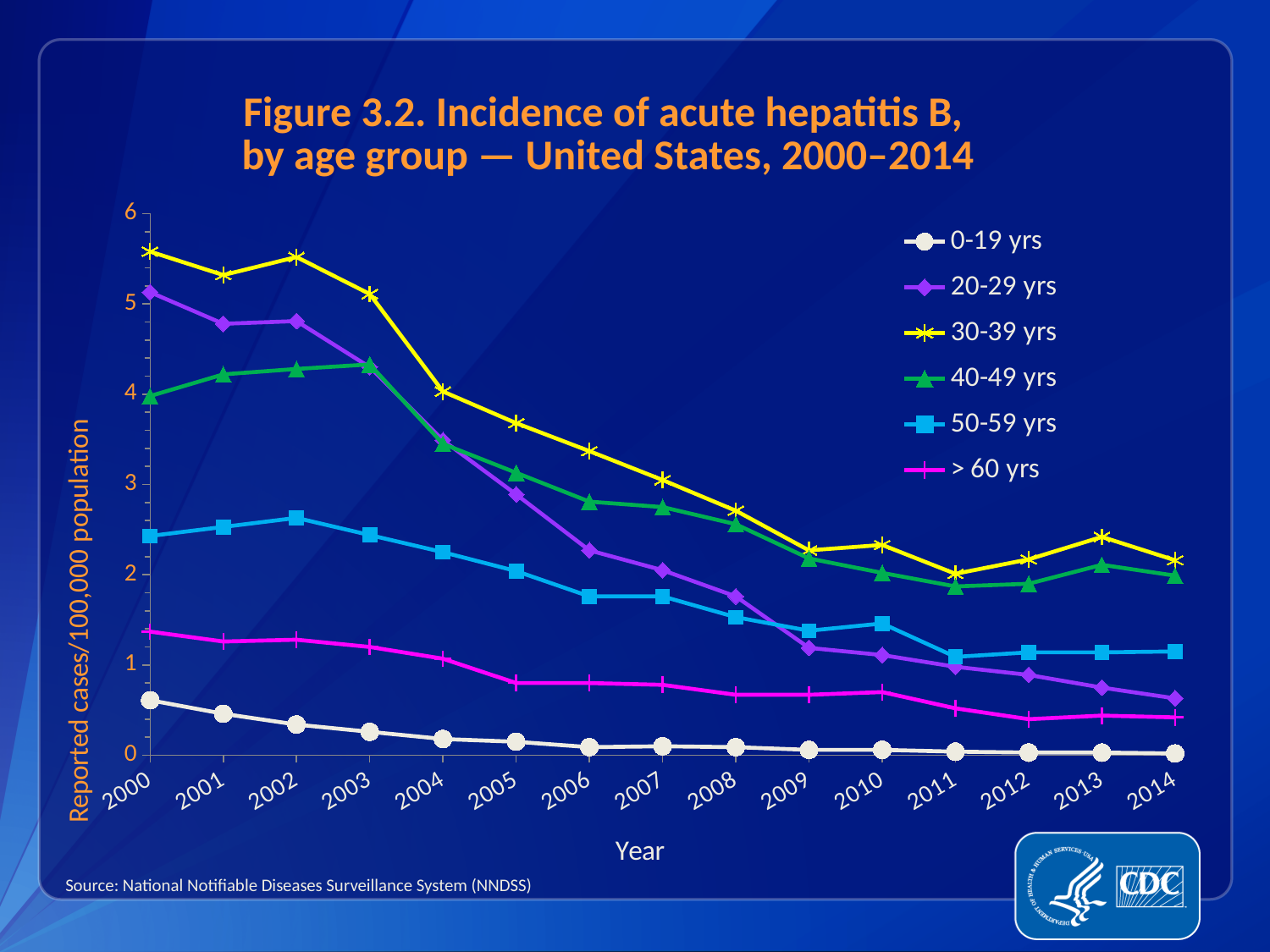
What is the label of the y axis? Reported cases/100,000 population Which age group has the highest incidence in 2000? 30-39 yrs Does the incidence for the 30-39 yrs group rise or fall from 2000 to 2014? fall Is the value for 0-19 yrs in 2014 greater or less than 1? less In 2014, which is larger: the value for 20-29 yrs or the value for 50-59 yrs? 50-59 yrs How many age-group series does the legend list? 6 What kind of chart is shown on the slide? line chart Is the value for 50-59 yrs in 2002 greater or less than 2? greater Which age group has the highest incidence in 2005? 30-39 yrs Is the value for 30-39 yrs in 2000 greater or less than 5? greater How many years are plotted along the x axis? 15 Which age group has the lowest incidence in 2000? 0-19 yrs